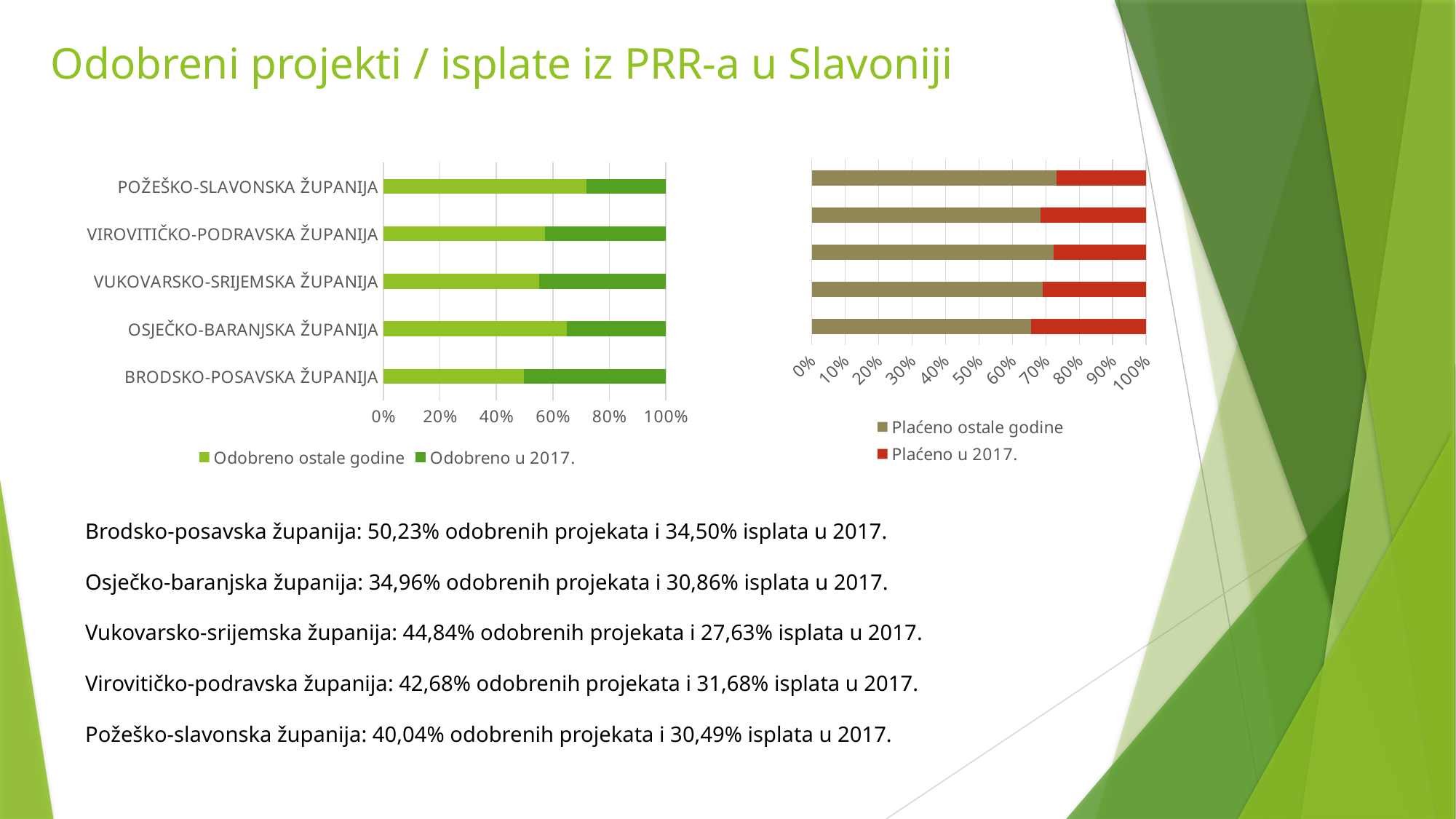
On the left chart, what is the total of each stacked bar? 100% On the left chart, is the 'Odobreno ostale godine' value for BRODSKO-POSAVSKA ŽUPANIJA greater or less than 60%? less How many counties (categories) are shown on the left chart? 5 On the left chart, which county has the largest 'Odobreno ostale godine' share? POŽEŠKO-SLAVONSKA ŽUPANIJA How many series does the legend of the right chart list? 2 On the left chart, which county has the smallest 'Odobreno ostale godine' share? BRODSKO-POSAVSKA ŽUPANIJA On the left chart, is the 'Odobreno ostale godine' value for VUKOVARSKO-SRIJEMSKA ŽUPANIJA greater or less than 60%? less On the left chart, which is larger: the 'Odobreno u 2017.' share for BRODSKO-POSAVSKA ŽUPANIJA or for POŽEŠKO-SLAVONSKA ŽUPANIJA? BRODSKO-POSAVSKA ŽUPANIJA What kind of chart is the left chart (Odobreno)? bar chart How many series does the legend of the left chart list? 2 What are the two legend entries of the right chart? Plaćeno ostale godine; Plaćeno u 2017. On the left chart, is the 'Odobreno ostale godine' value for OSJEČKO-BARANJSKA ŽUPANIJA greater or less than 60%? greater